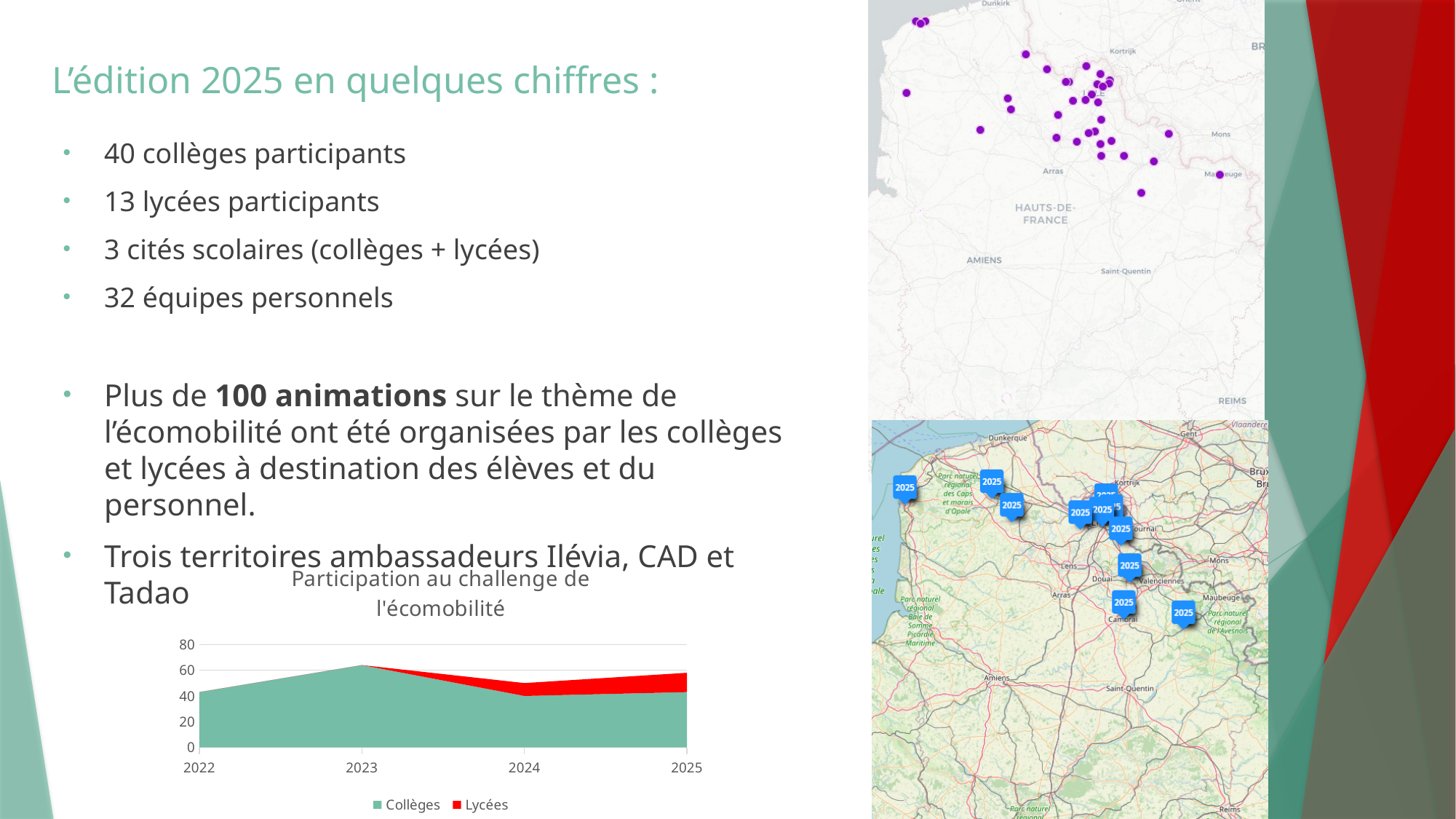
In the 'Participation au challenge de l'écomobilité' chart, what colour represents the Lycées series? Red In the 'Participation au challenge de l'écomobilité' chart, does the Lycées series rise or fall from 2022 to 2025? Rises In the 'Participation au challenge de l'écomobilité' chart, is the Collèges value for 2022 greater or less than 60? less In the 'Participation au challenge de l'écomobilité' chart, is the Collèges value for 2024 greater or less than 60? less In the 'Participation au challenge de l'écomobilité' chart, in which year is the Collèges value highest? 2023 In the 'Participation au challenge de l'écomobilité' chart, is the Collèges value for 2023 larger than the Collèges value for 2024? Yes, 2023 What kind of chart is 'Participation au challenge de l'écomobilité'? Area chart In the 'Participation au challenge de l'écomobilité' chart, is the Lycées value for 2025 greater or less than 40? less Which series are listed in the legend of the 'Participation au challenge de l'écomobilité' chart? Collèges and Lycées How many years are shown on the x axis of the 'Participation au challenge de l'écomobilité' chart? 4 How many series does the legend of the 'Participation au challenge de l'écomobilité' chart list? 2